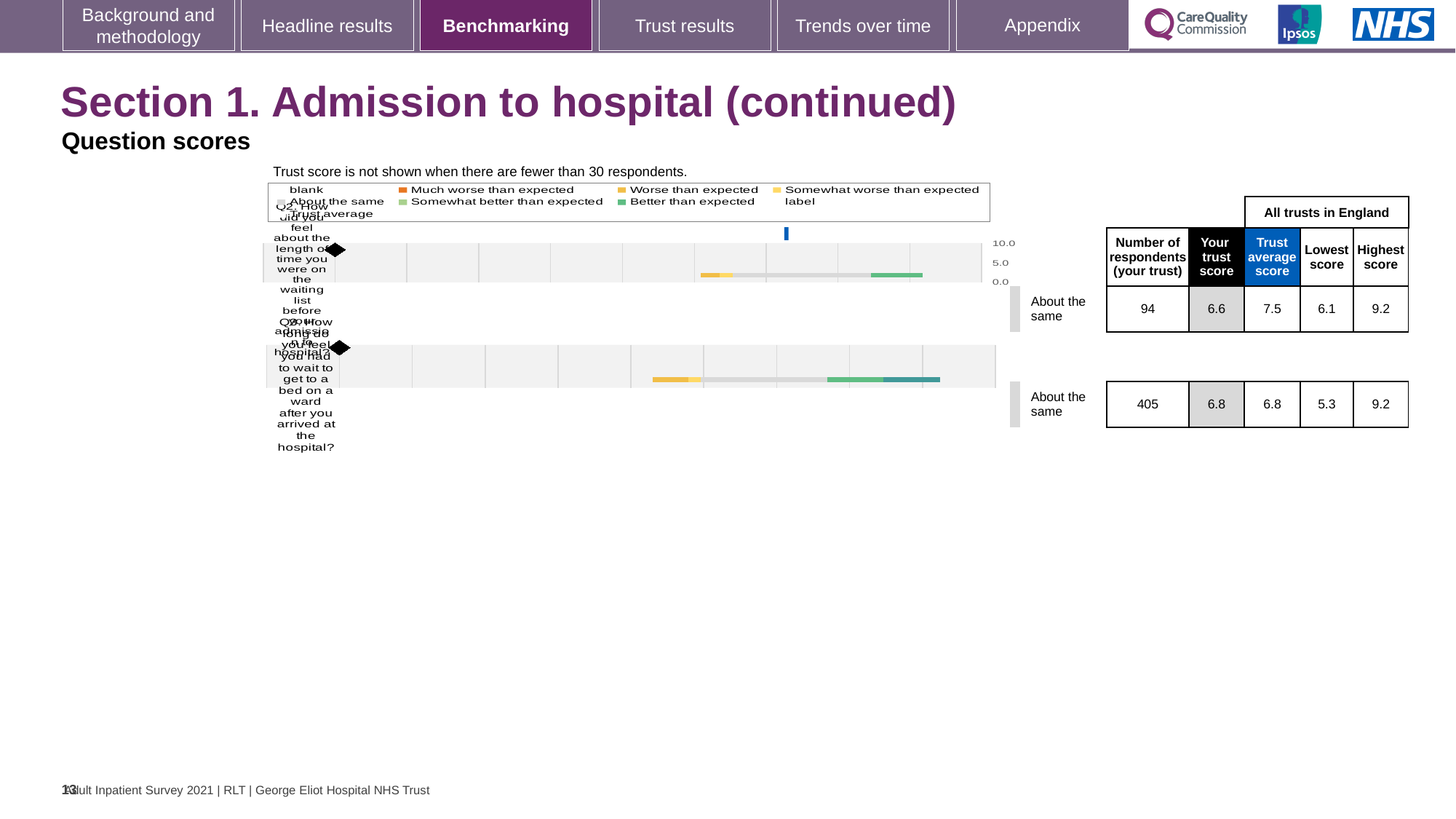
How many respondents answered Q2 at this trust? 94 What kind of chart is used to show the question scores? Bar chart What is the trust score for Q2 (how did you feel about the length of time on the waiting list before admission)? 6.6 What is the trust average score across all trusts in England for Q2? 7.5 What is the trust score for Q3 (how long did you feel you had to wait to get to a bed on a ward)? 6.8 By how much does the all-trusts average score for Q2 exceed this trust's score for Q2? 0.9 How many questions are plotted on the slide? 2 Which question had more respondents at this trust, Q2 or Q3? Q3 How many respondents answered Q3 at this trust? 405 What is the lowest score across all trusts in England for Q2? 6.1 What benchmark category is shown next to the Q2 chart? About the same What is the highest score across all trusts in England for Q3? 9.2